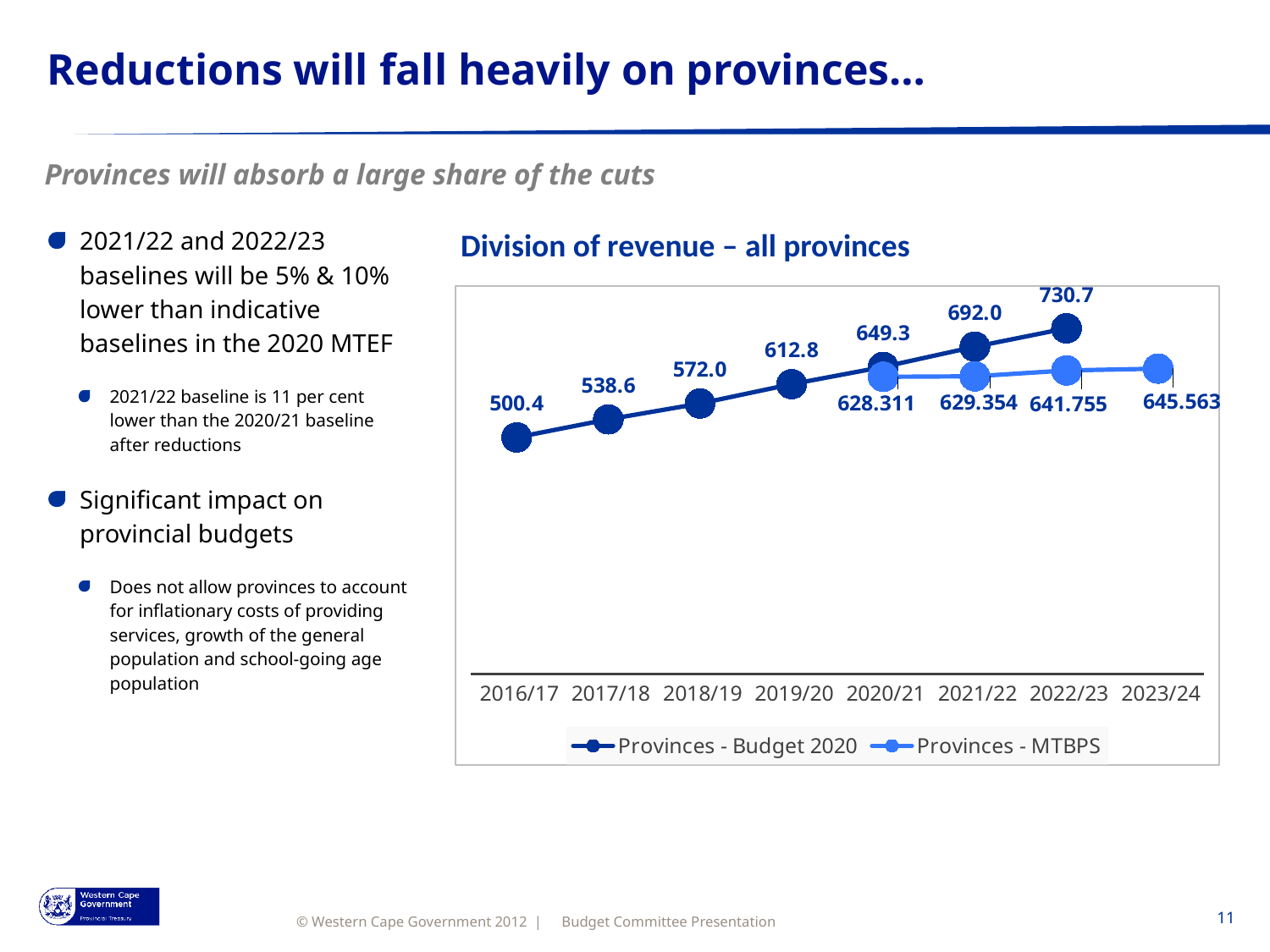
What is the value for Provinces - MTBPS in 2020/21? 628.311 Does the Provinces - Budget 2020 series rise or fall from 2016/17 to 2022/23? Rise What is the value for Provinces - Budget 2020 in 2016/17? 500.4 Which year has the lowest value for Provinces - Budget 2020? 2016/17 What type of chart is shown on the slide? Line chart How many series does the chart legend list? 2 How many categories are shown on the x axis of the chart? 8 What is the difference between Provinces - Budget 2020 and Provinces - MTBPS in 2022/23? 88.945 What is the value for Provinces - Budget 2020 in 2022/23? 730.7 Which year has the highest value for Provinces - Budget 2020? 2022/23 What is the value for Provinces - MTBPS in 2023/24? 645.563 What is the title of the chart? Division of revenue – all provinces